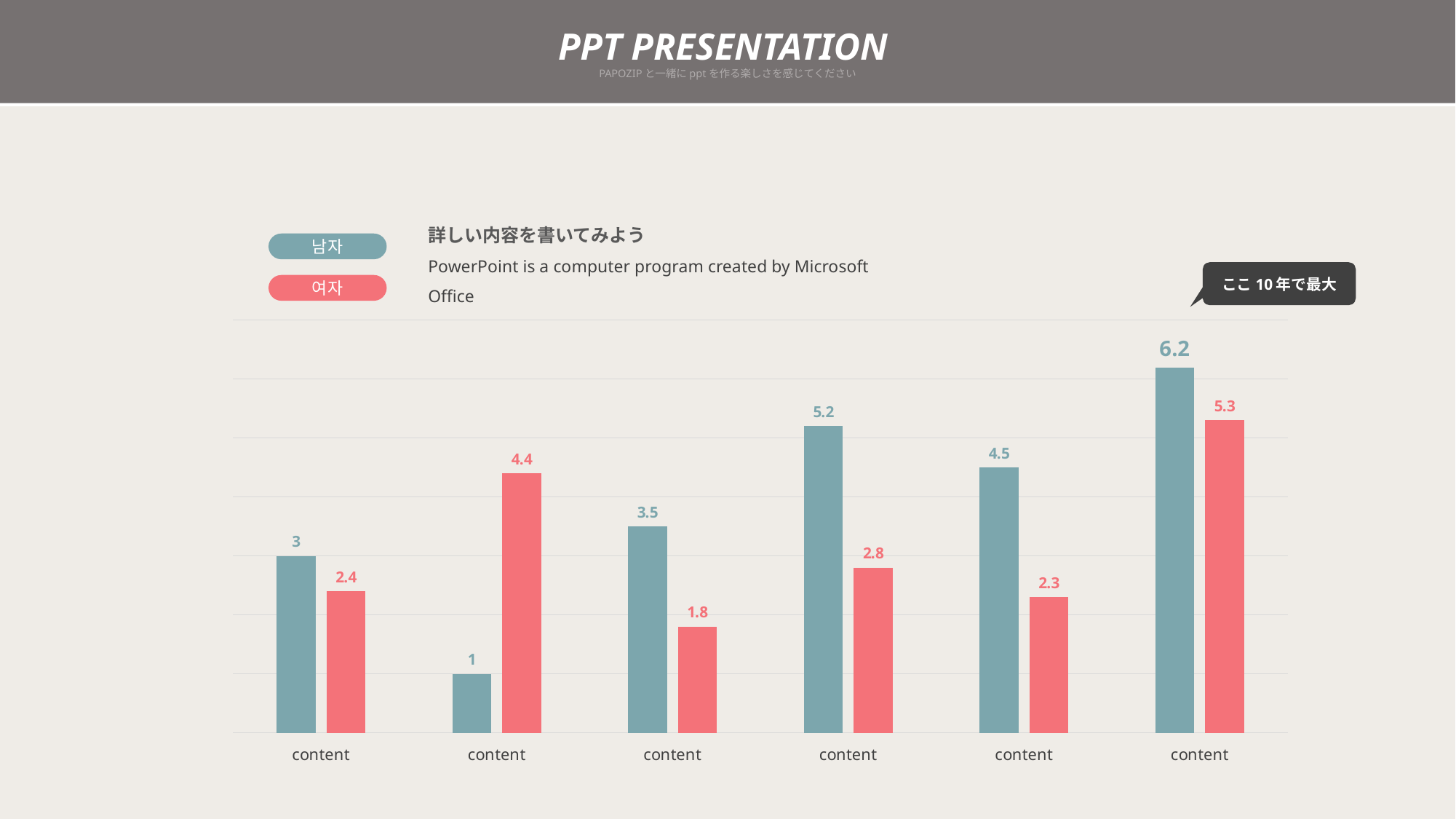
In the third category from the left, which series has the larger value, 남자 or 여자? 남자 What kind of chart is shown on the slide? bar chart What is the highest value in the 남자 series? 6.2 How many series does the legend list? 2 How many categories are shown on the x axis? 6 What is the value of the 여자 series for the fifth category from the left? 2.3 What is the lowest value in the 여자 series? 1.8 What is the value of the 여자 series for the second category from the left? 4.4 What is the difference between the 남자 and 여자 values for the rightmost category? 0.9 What is the value of the 남자 series for the first category from the left? 3 What colour are the bars for the 여자 series? red What is the value of the 남자 series for the fourth category from the left? 5.2